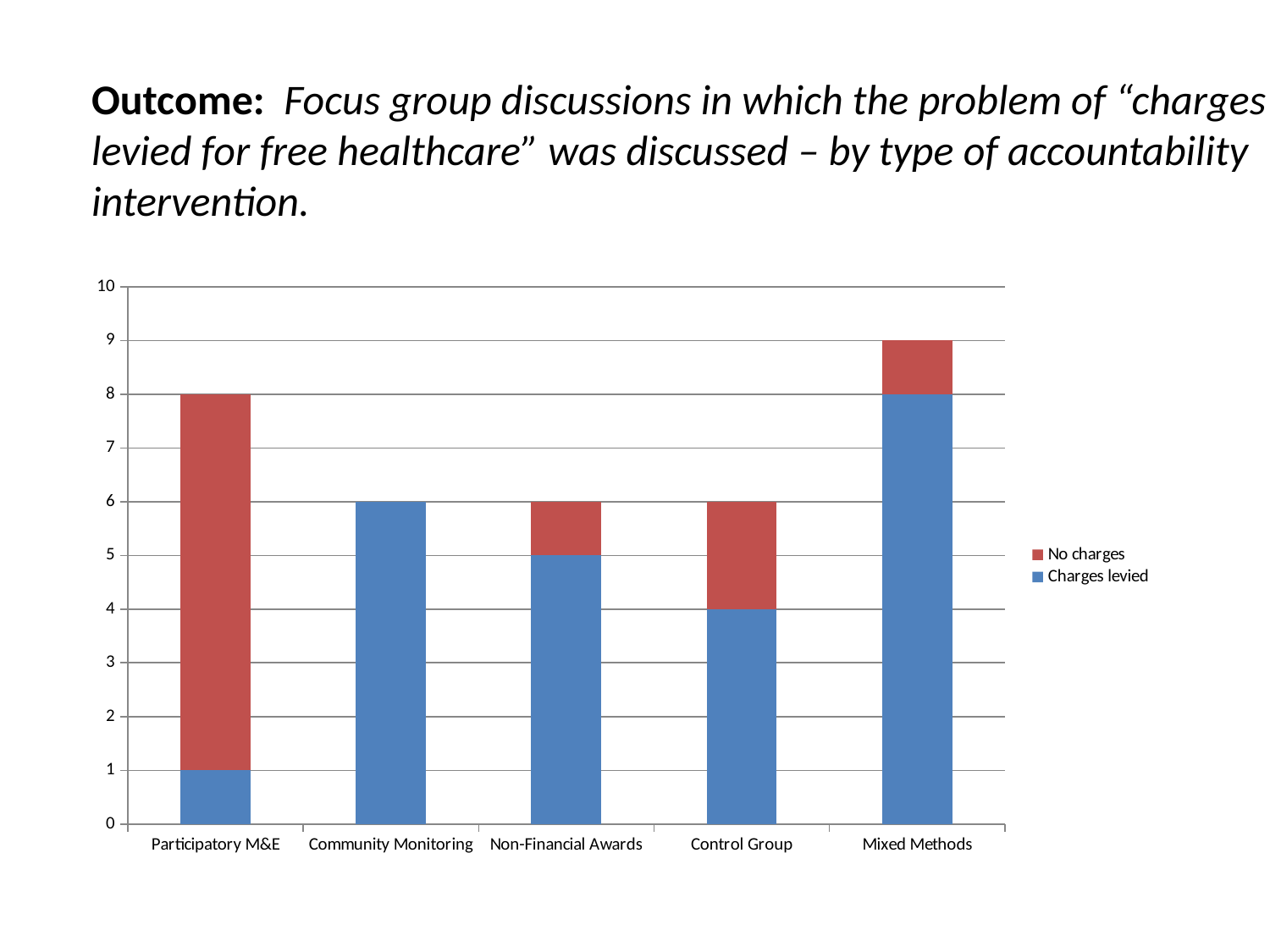
What is the value of 'Charges levied' for Mixed Methods? 8 What kind of chart is shown on the slide? Stacked bar chart How many intervention categories are shown on the x axis? 5 What is the value of 'Charges levied' for Control Group? 4 What is the total height of the stacked bar for Mixed Methods? 9 What is the value of 'Charges levied' for Participatory M&E? 1 Which category has the highest total stacked bar? Mixed Methods What is the total height of the stacked bar for Participatory M&E? 8 Which is larger, the 'Charges levied' value for Community Monitoring or for Control Group? Community Monitoring Which colour represents 'No charges' in the legend? Red How many series does the legend list? 2 Which category has the lowest 'Charges levied' value? Participatory M&E